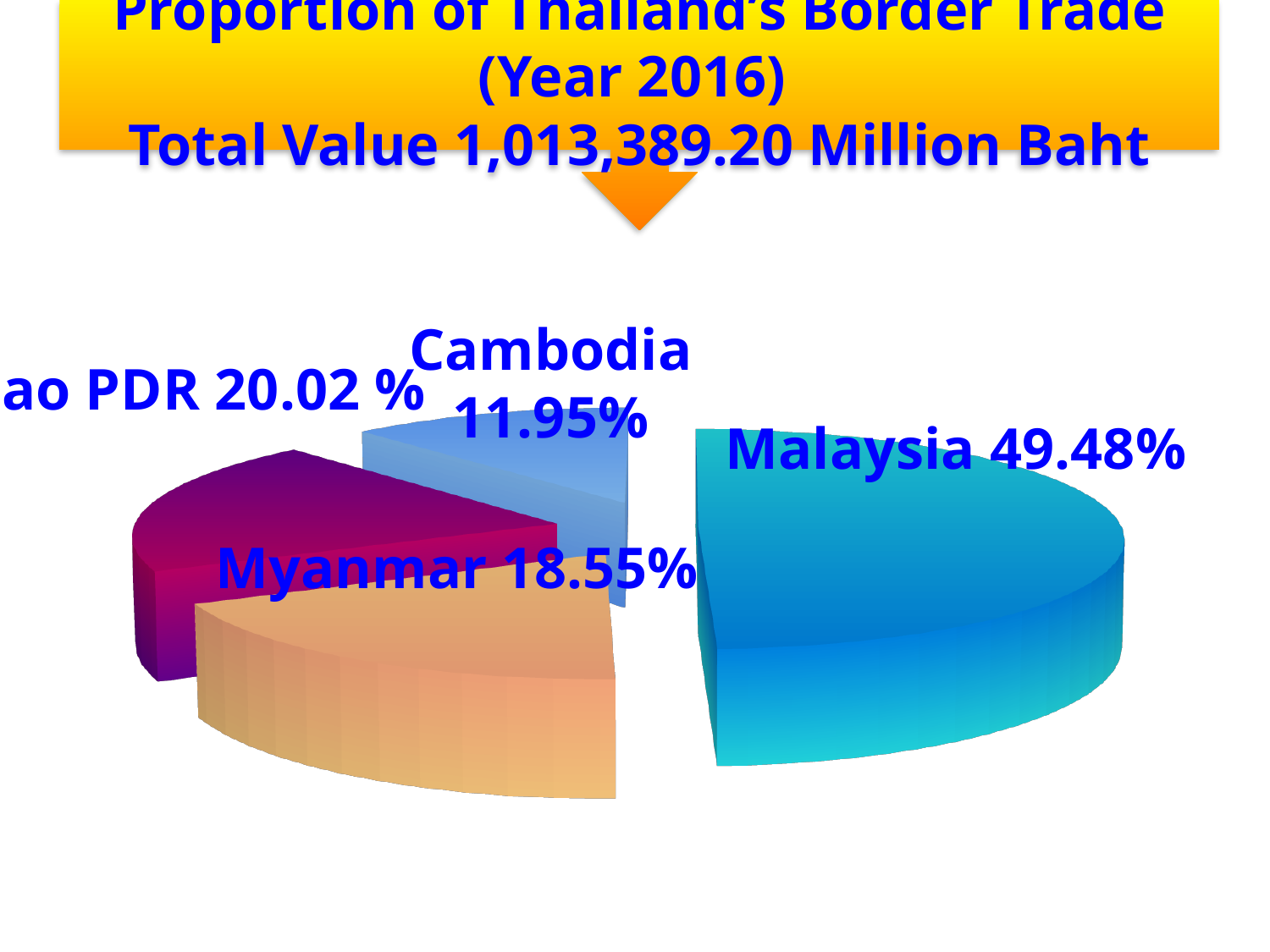
How many countries are shown as slices in the pie chart? 4 What total value of border trade is stated in the chart title? 1,013,389.20 Million Baht What is the value shown for Cambodia? 11.95% Which has a larger share, Lao PDR or Myanmar? Lao PDR What percentage of the pie is labelled for Myanmar? 18.55% What is the difference in percentage points between Malaysia's share and Myanmar's share? 30.93 What type of chart is shown on the slide? Pie chart What percentage is shown for Lao PDR? 20.02 % Which country has the largest share of Thailand's border trade in the chart? Malaysia Which year does the chart title say the border trade proportions are for? 2016 What share of Thailand's border trade in 2016 does Malaysia account for? 49.48% Which country has the smallest slice of the pie? Cambodia